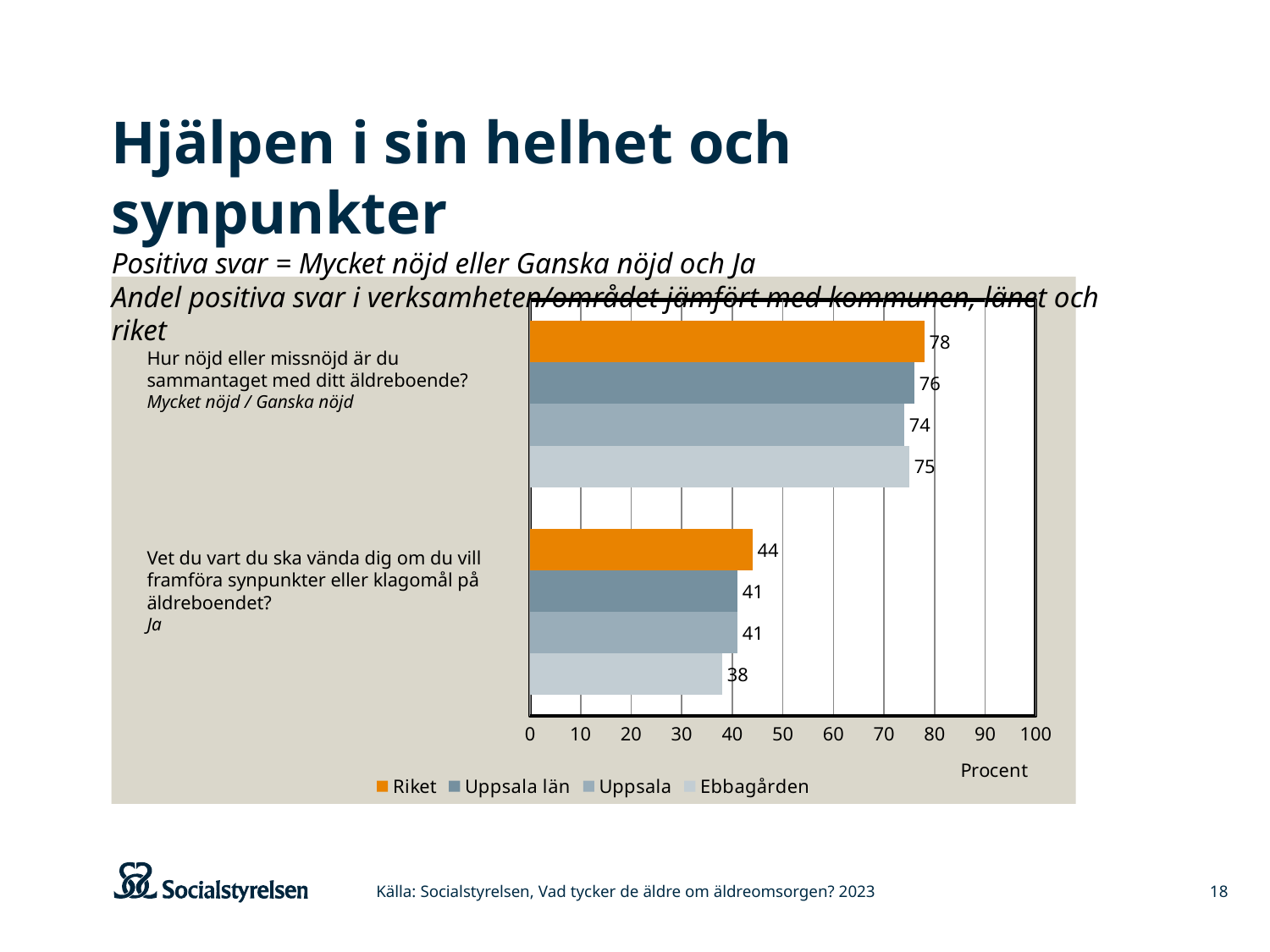
What is the value for Ebbagården on the question "Vet du vart du ska vända dig om du vill framföra synpunkter eller klagomål på äldreboendet?"? 38 Is the value for Riket on the question "Vet du vart du ska vända dig om du vill framföra synpunkter eller klagomål på äldreboendet?" greater or less than 50? less What is the value for Ebbagården on the question "Hur nöjd eller missnöjd är du sammantaget med ditt äldreboende?"? 75 What is the value for Uppsala län on the question "Vet du vart du ska vända dig om du vill framföra synpunkter eller klagomål på äldreboendet?"? 41 What unit label is shown on the x axis of the chart? Procent How many series does the legend list? 4 Which series has the highest value on the question "Vet du vart du ska vända dig om du vill framföra synpunkter eller klagomål på äldreboendet?"? Riket Which series has the lowest value on the question "Hur nöjd eller missnöjd är du sammantaget med ditt äldreboende?"? Uppsala Which is larger on the question "Hur nöjd eller missnöjd är du sammantaget med ditt äldreboende?": the value for Uppsala län or the value for Uppsala? Uppsala län What is the value for Riket on the question "Hur nöjd eller missnöjd är du sammantaget med ditt äldreboende?"? 78 What is the difference between the Riket value and the Ebbagården value on the question "Vet du vart du ska vända dig om du vill framföra synpunkter eller klagomål på äldreboendet?"? 6 What kind of chart is shown on the slide? bar chart